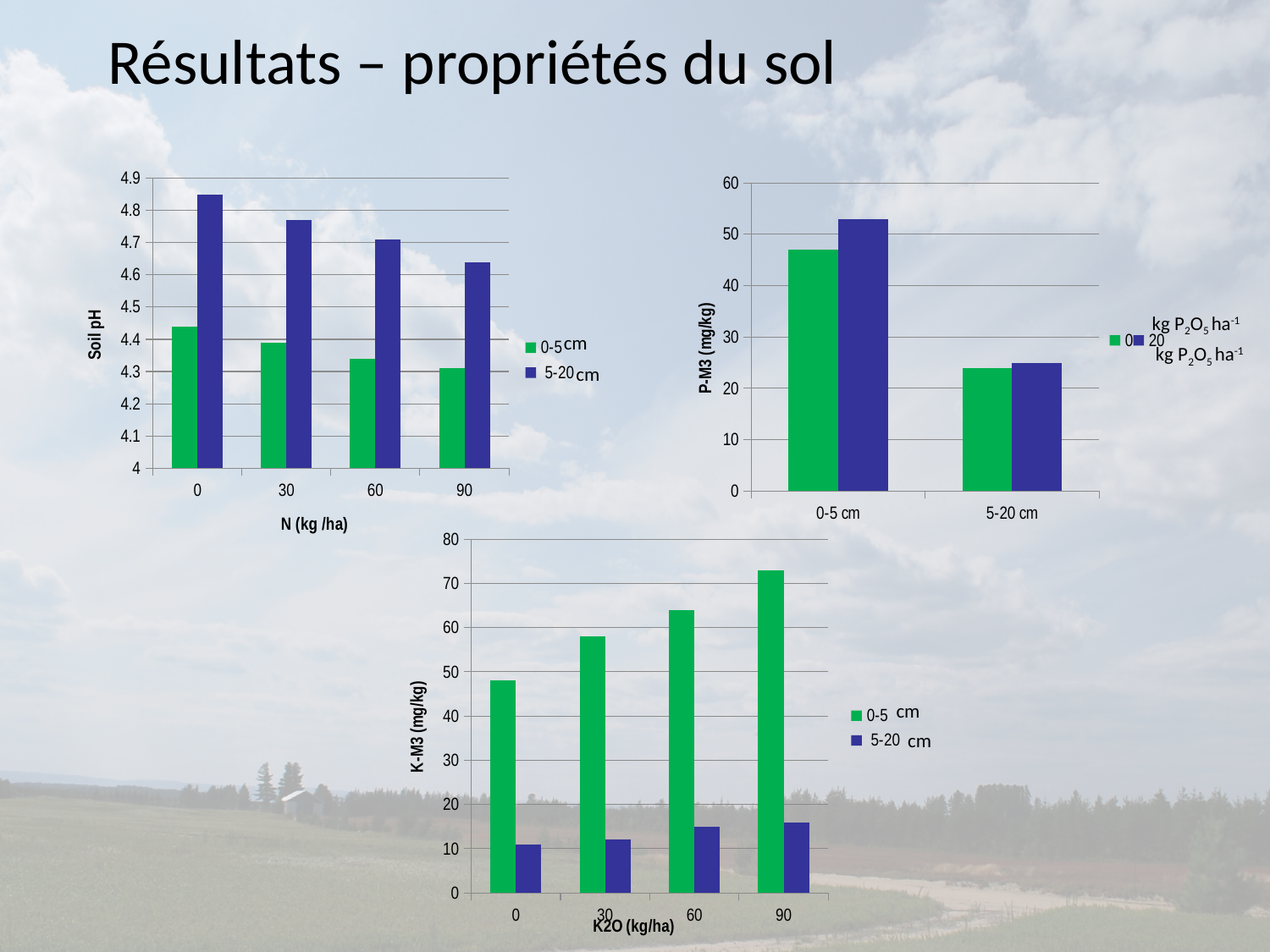
In the Soil pH chart (top left), is the 5-20 cm value at N = 0 greater or less than 4.8? greater In the P-M3 chart (top right), for the 0 kg P2O5/ha series, which depth has the larger value, 0-5 cm or 5-20 cm? 0-5 cm What type of chart is the K-M3 chart at the bottom of the slide? Bar chart In the K-M3 chart (bottom), is the 0-5 cm value at K2O = 90 greater or less than 70? greater In the Soil pH chart (top left), at which N level is the 5-20 cm soil pH highest? 0 In the K-M3 chart (bottom), how do the 0-5 cm values change as K2O increases from 0 to 90 kg/ha? They rise In the K-M3 chart (bottom), which series has the lower values at every K2O level? 5-20 cm In the Soil pH chart (top left), is the 0-5 cm value at N = 90 greater or less than 4.4? less In the Soil pH chart (top left), how do the 5-20 cm values change as N increases from 0 to 90 kg/ha? They fall In the Soil pH chart (top left), how many series does the legend list? 2 In the P-M3 chart (top right), how many depth categories are shown on the x axis? 2